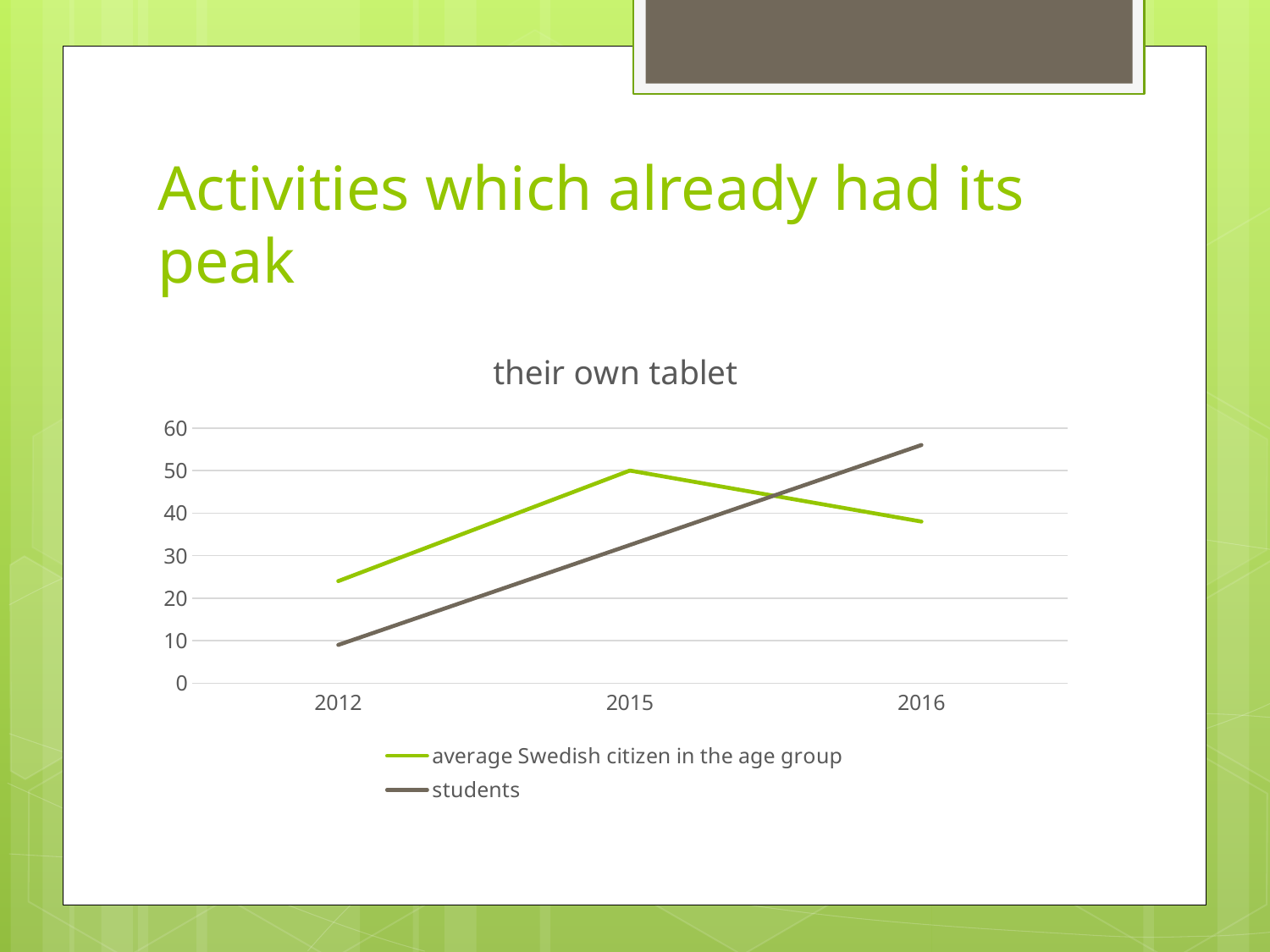
In 2016, which series has the higher value? students What kind of chart is shown on the slide? line chart Is the value for average Swedish citizen in the age group in 2012 greater or less than 20? greater Is the value for students in 2016 greater or less than 50? greater In which year does the average Swedish citizen in the age group series reach its highest value? 2015 Is the value for average Swedish citizen in the age group in 2016 greater or less than 40? less In 2012, which series has the higher value? average Swedish citizen in the age group What is the title of the chart? their own tablet How many series does the legend list? 2 Which series is drawn in green? average Swedish citizen in the age group How many years are shown on the x axis? 3